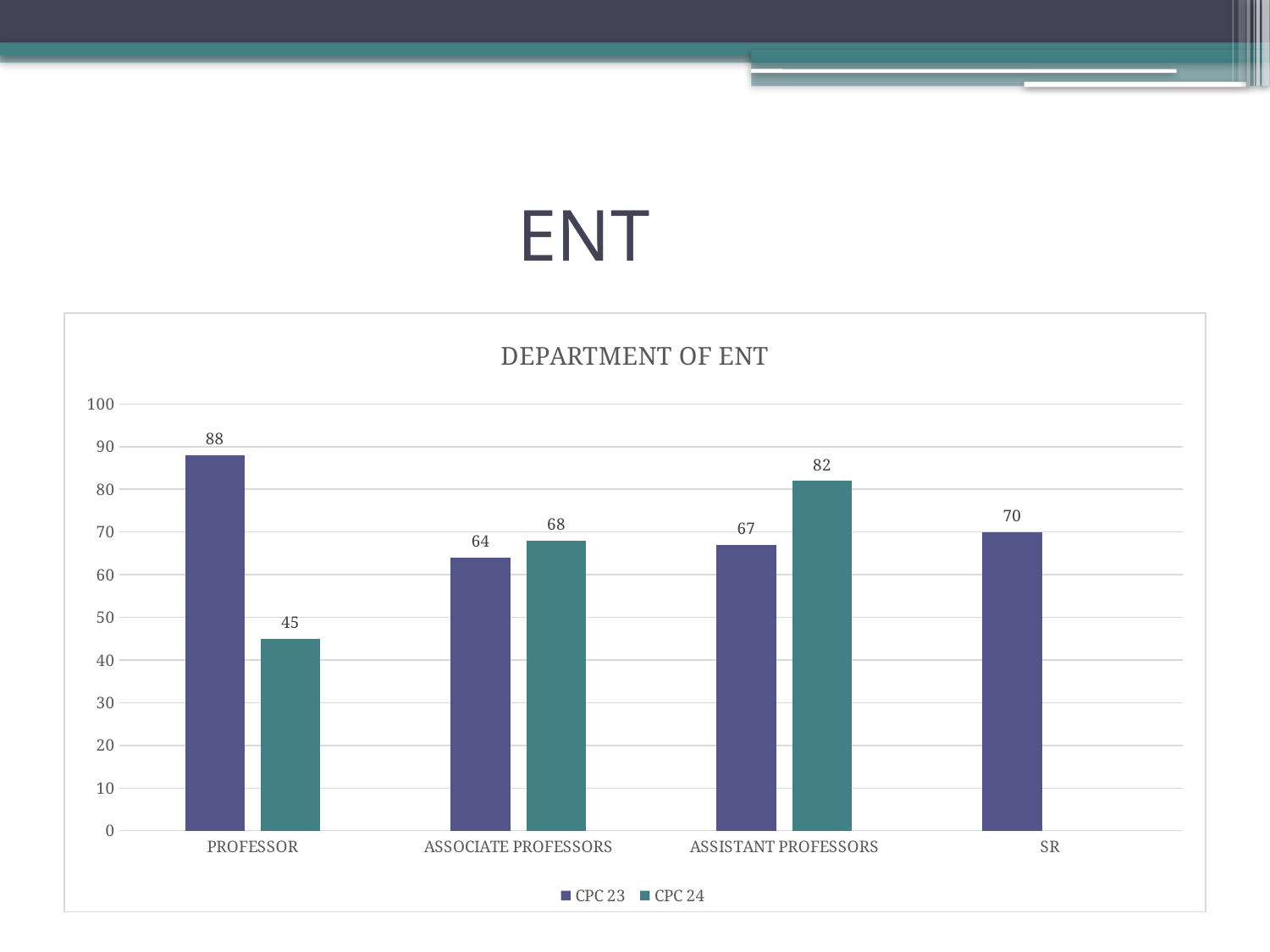
How many categories are shown on the x axis? 4 What is the difference between the CPC 23 and CPC 24 values for PROFESSOR? 43 Which category has the lowest CPC 23 value? ASSOCIATE PROFESSORS Is the CPC 24 value for PROFESSOR greater or less than 50? less What is the CPC 24 value for ASSISTANT PROFESSORS? 82 How many series does the legend list? 2 What is the title of the chart? DEPARTMENT OF ENT What kind of chart is shown? bar chart What is the CPC 23 value for PROFESSOR? 88 What is the CPC 23 value for SR? 70 Which is larger for ASSOCIATE PROFESSORS, CPC 23 or CPC 24? CPC 24 Which category has the highest CPC 24 value? ASSISTANT PROFESSORS